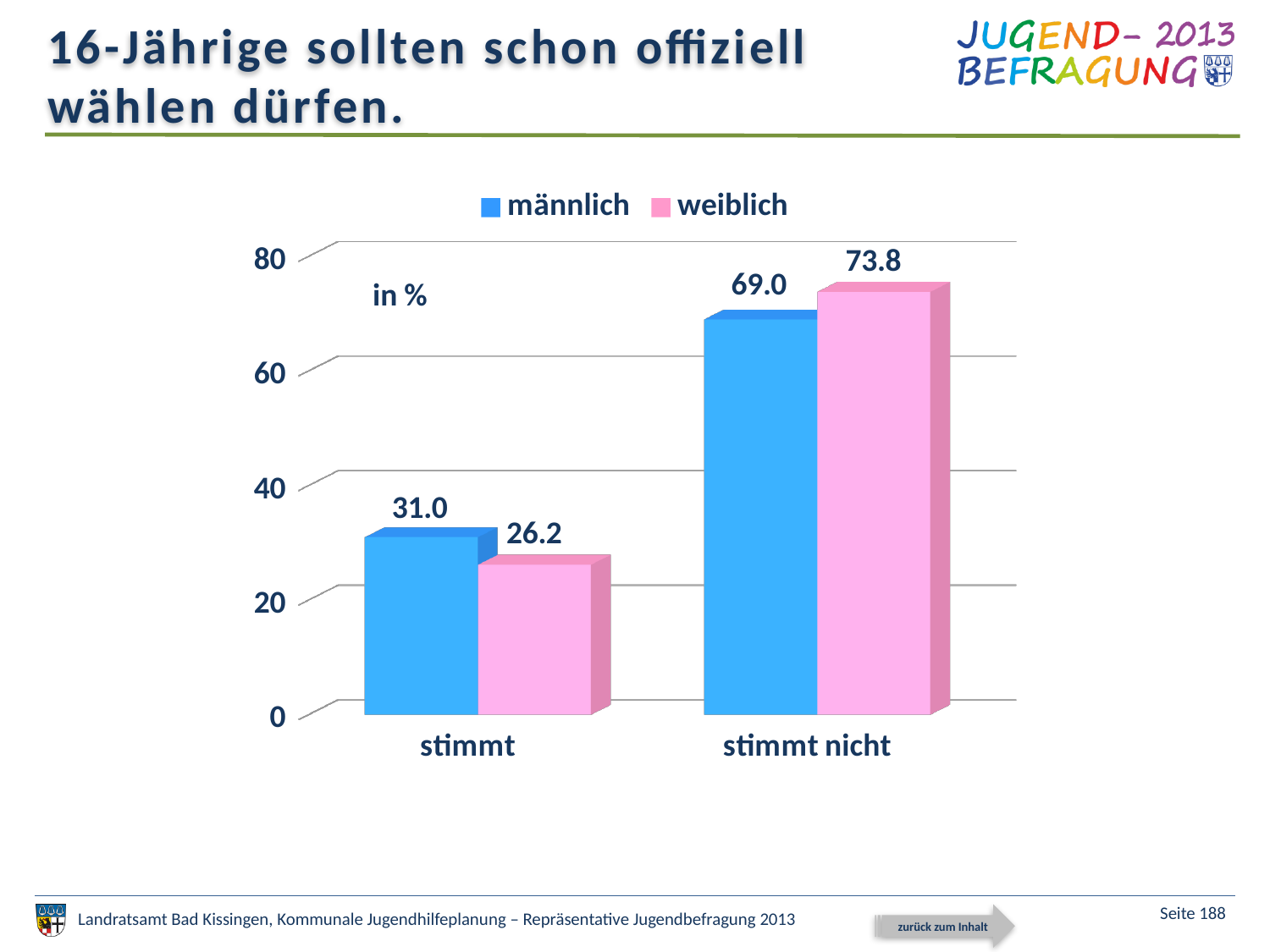
What is the difference between the weiblich and männlich values in the stimmt nicht category? 4.8 What is the value for weiblich in the stimmt nicht category? 73.8 Is the value for männlich in the stimmt nicht category greater or less than 60? greater Which series has the lowest value in the stimmt category? weiblich What is the value for weiblich in the stimmt category? 26.2 How many categories are shown on the x axis? 2 What is the value for männlich in the stimmt category? 31.0 How many series does the legend list? 2 Which series has the highest value in the stimmt nicht category? weiblich Which is larger: männlich for stimmt or weiblich for stimmt? männlich for stimmt What is the value for männlich in the stimmt nicht category? 69.0 What kind of chart is shown on the slide? bar chart